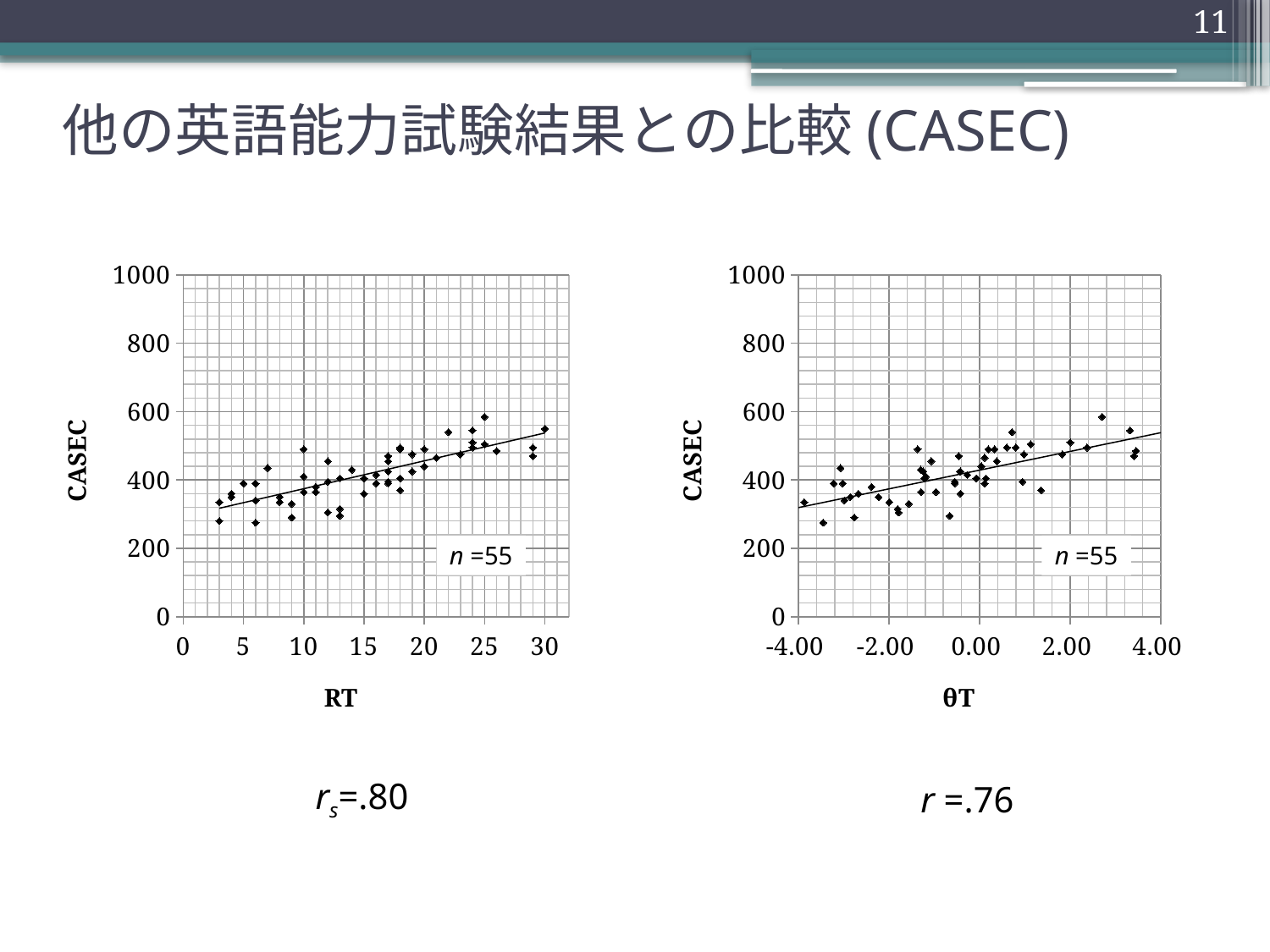
In the right chart, do CASEC values generally rise or fall as θT increases? rise In the left chart, do CASEC values generally rise or fall as RT increases? rise What is the maximum value shown on the y axis of the right chart? 1000 What is the label of the x axis of the left chart? RT What kind of chart is the right chart (CASEC vs θT)? scatter plot In the right chart, how many data points are plotted according to the n label? 55 In the left chart, is the highest CASEC value plotted greater or less than 600? less In the right chart, is the lowest CASEC value plotted greater or less than 400? less In the left chart, is the CASEC value of the point at RT = 30 greater or less than 500? greater What correlation coefficient is reported below the right chart? r =.76 What kind of chart is the left chart (CASEC vs RT)? scatter plot In the left chart, how many data points are plotted according to the n label? 55